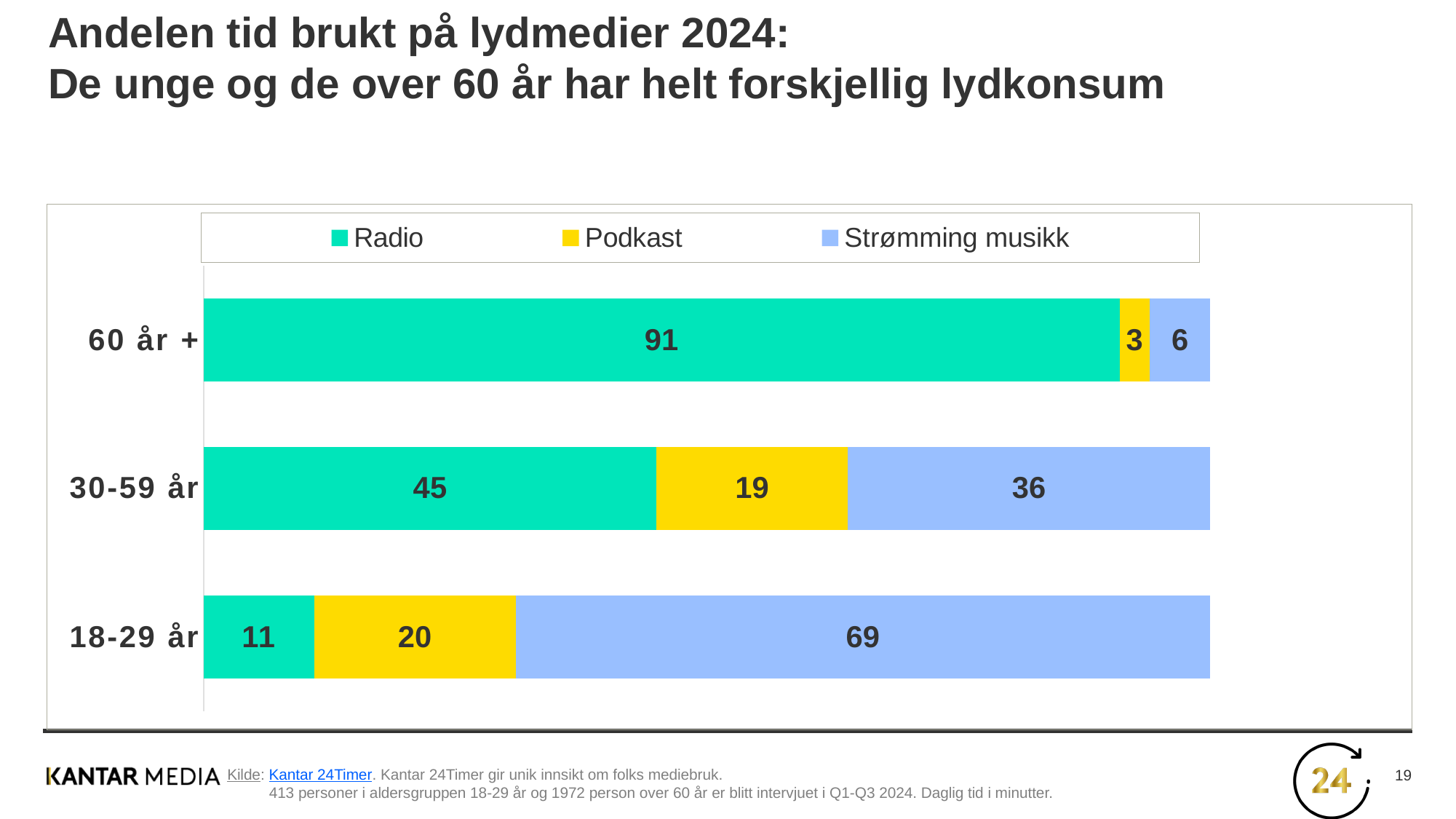
What is the difference between the Strømming musikk values for 18-29 år and 30-59 år? 33 Which is larger: the Podkast value for 18-29 år or for 30-59 år? 18-29 år How many age groups are shown in the chart? 3 Which age group has the highest Radio value? 60 år + Which age group has the lowest Strømming musikk value? 60 år + How many series does the legend list? 3 What is the Radio value for the 60 år + age group? 91 What is the Podkast value for the 30-59 år age group? 19 What kind of chart is shown on the slide? Stacked bar chart What is the Strømming musikk value for the 18-29 år age group? 69 What is the total of the stacked bar for 30-59 år? 100 Which colour represents Podkast in the chart? Yellow